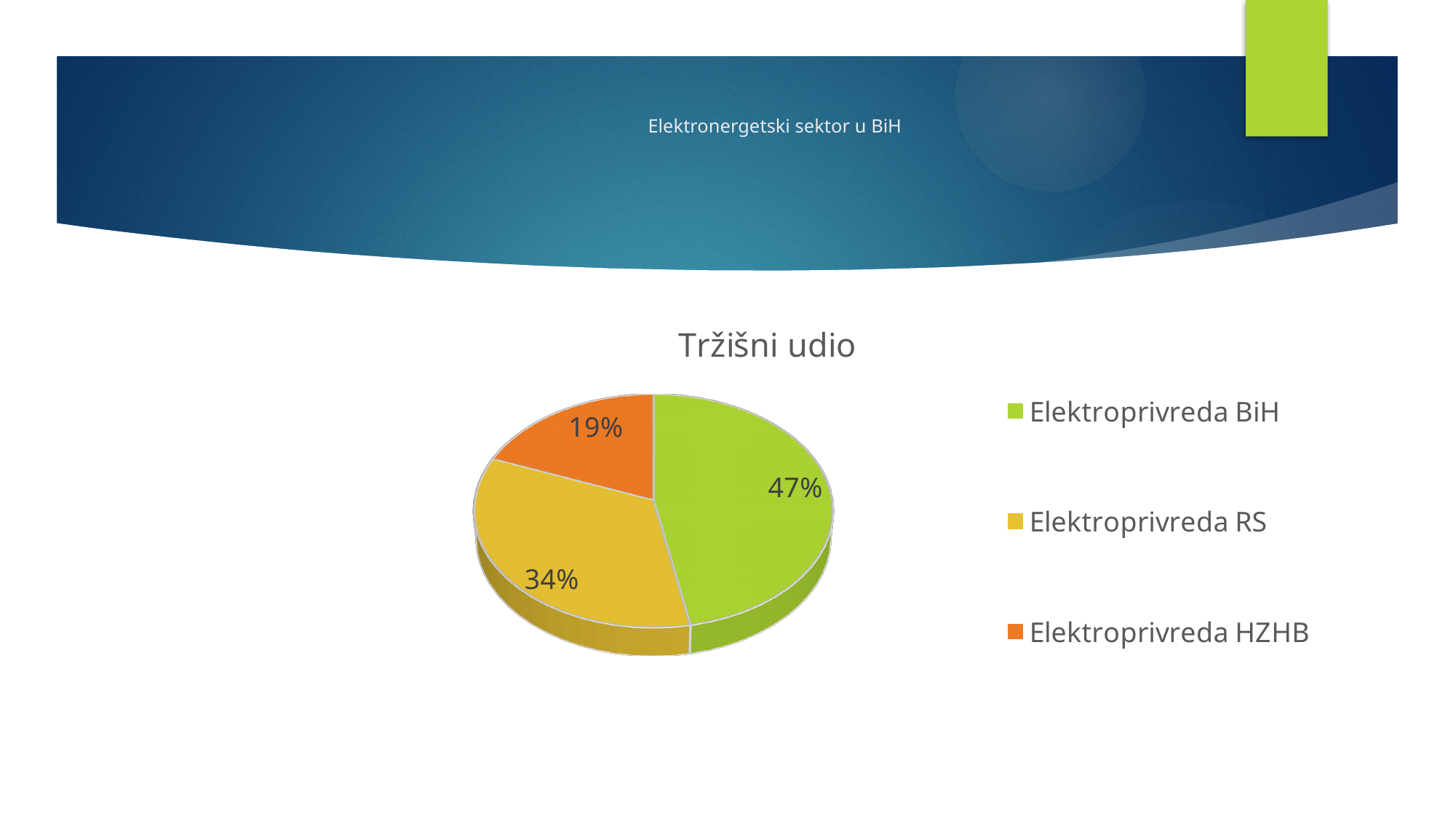
What is the market share shown for Elektroprivreda BiH? 47% What is the difference in percentage points between Elektroprivreda RS and Elektroprivreda HZHB? 15 What is the title of the chart? Tržišni udio Which company has the largest slice of the pie? Elektroprivreda BiH Which company has the smallest slice of the pie? Elektroprivreda HZHB How many slices does the pie chart have? 3 Which colour represents Elektroprivreda HZHB in the chart? Orange What is the market share shown for Elektroprivreda RS? 34% Which has a larger share, Elektroprivreda RS or Elektroprivreda HZHB? Elektroprivreda RS What kind of chart is shown on the slide? Pie chart What is the market share shown for Elektroprivreda HZHB? 19% What is the difference in percentage points between Elektroprivreda BiH and Elektroprivreda RS? 13